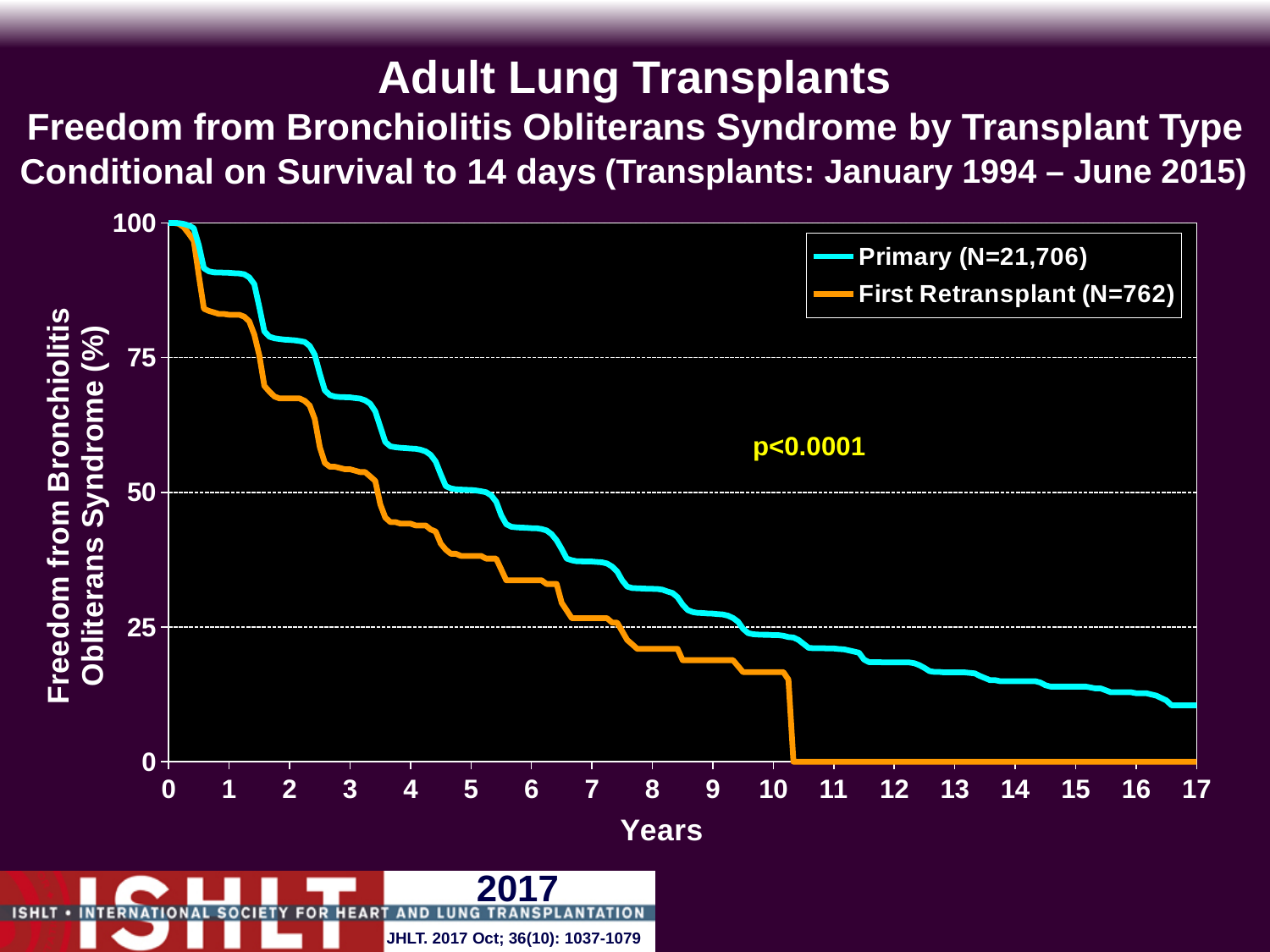
Is the value for the First Retransplant series at year 8 greater or less than 25? less How many series does the legend list? 2 What is the N for the Primary series shown in the legend? 21,706 Is the value for the First Retransplant series at year 2 greater or less than 50? greater Is the value for the Primary series at year 3 greater or less than 50? greater What p-value is printed on the chart? p<0.0001 At year 5, which series has the higher freedom from Bronchiolitis Obliterans Syndrome, Primary or First Retransplant? Primary What is the value for the First Retransplant series at year 12? 0 Do the values for the Primary series rise or fall as years increase? fall What kind of chart is shown on the slide? line chart